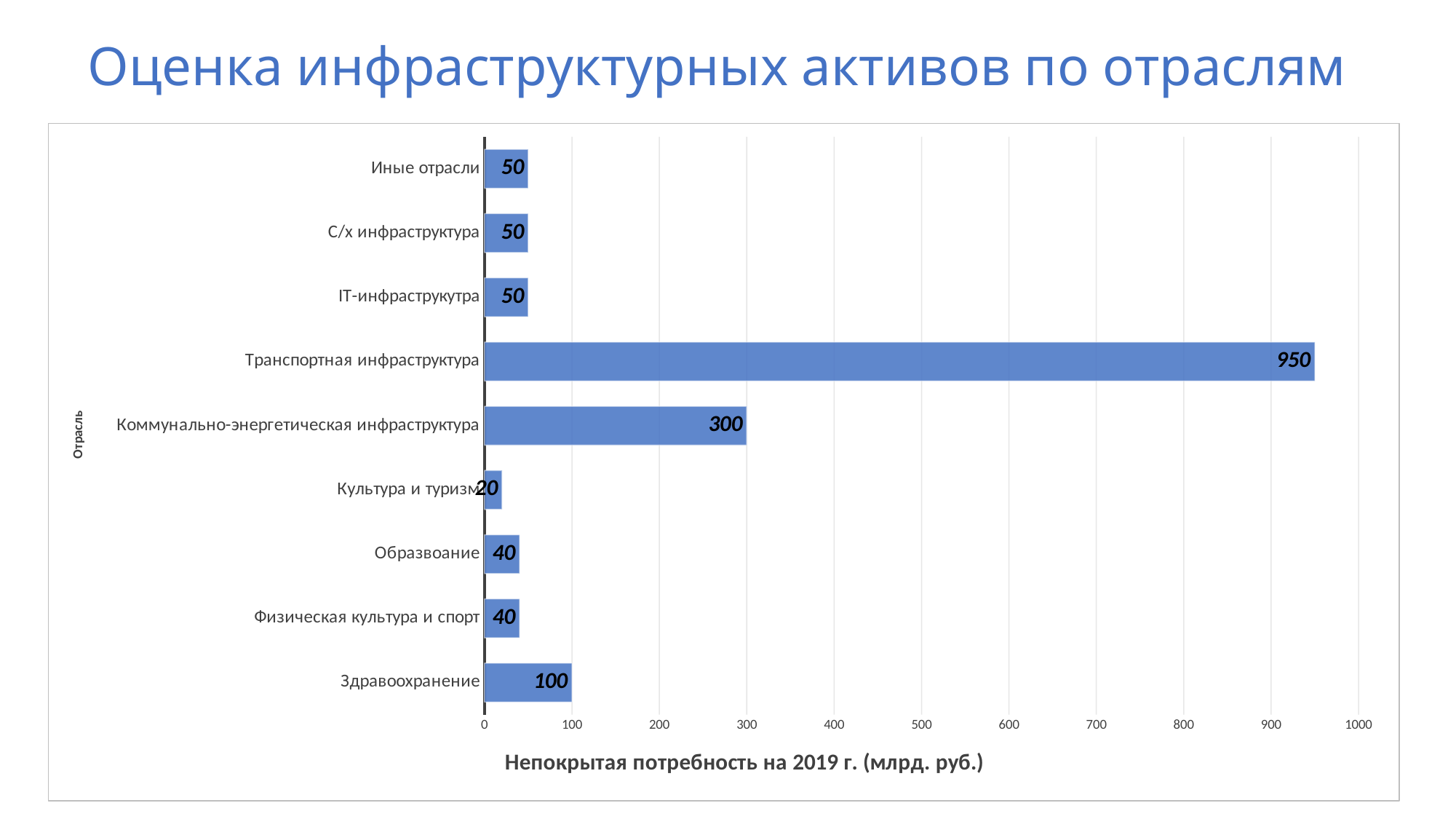
Which category has the lowest value? Культура и туризм What is the difference between the values for Здравоохранение and Образвоание? 60 What is the difference between the values for Транспортная инфраструктура and Коммунально-энергетическая инфраструктура? 650 What kind of chart is shown on the slide? Bar chart What is the value for Здравоохранение? 100 What is the value for Транспортная инфраструктура? 950 Which is larger, the value for Здравоохранение or the value for IT-инфраструктура? Здравоохранение What is the title of the horizontal axis? Непокрытая потребность на 2019 г. (млрд. руб.) What is the value for Культура и туризм? 20 How many categories are shown in the chart? 9 What is the value for Коммунально-энергетическая инфраструктура? 300 Which category has the highest value? Транспортная инфраструктура